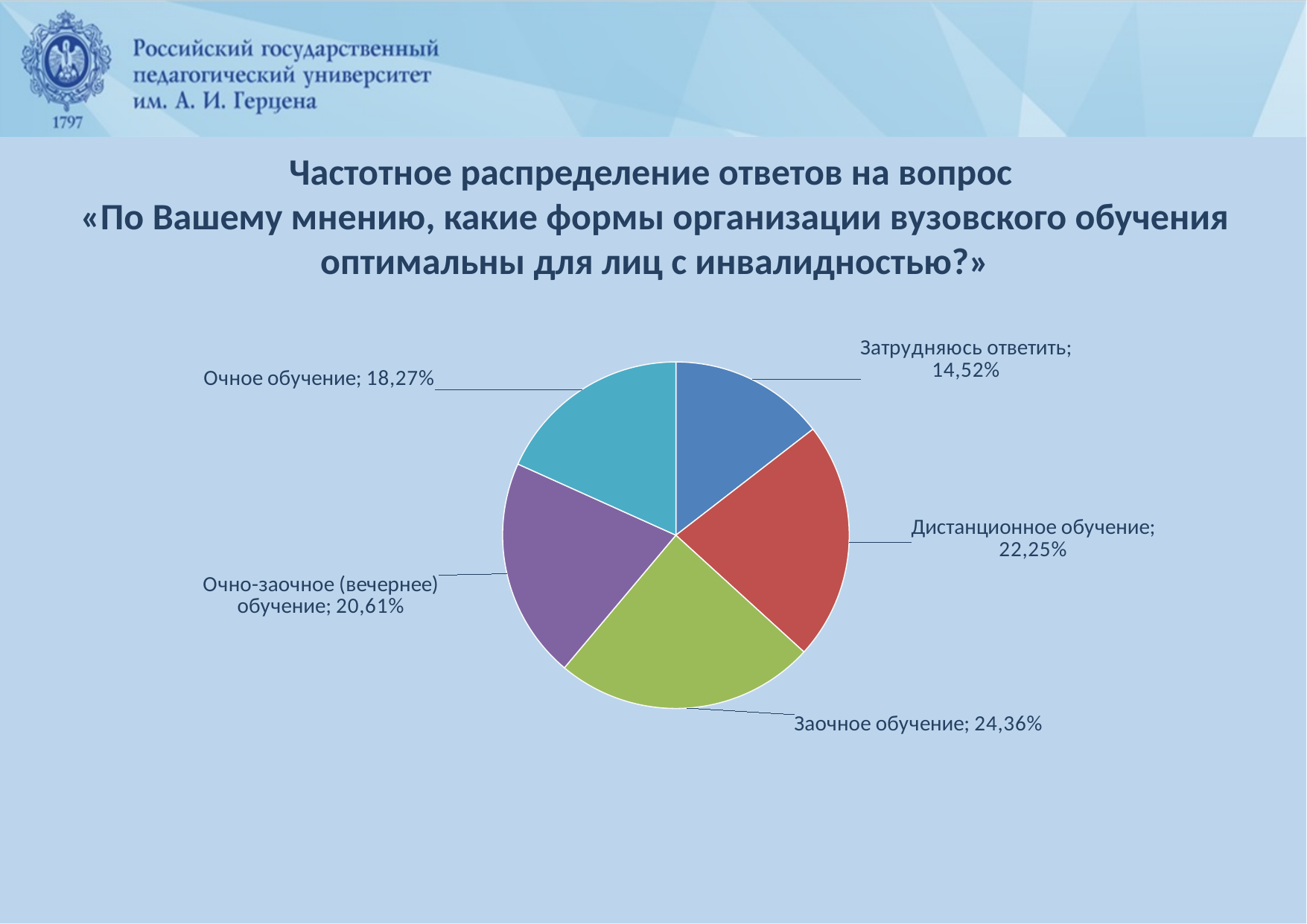
What percentage is shown for "Очное обучение"? 18,27% What is the difference in percentage points between "Заочное обучение" and "Дистанционное обучение"? 2,11 What share of responses does "Дистанционное обучение" have? 22,25% What type of chart is shown on the slide? Pie chart What percentage is shown for "Очно-заочное (вечернее) обучение"? 20,61% Which answer option has the smallest share in the pie chart? Затрудняюсь ответить Which has a larger share: "Очно-заочное (вечернее) обучение" or "Очное обучение"? Очно-заочное (вечернее) обучение What is the difference in percentage points between "Дистанционное обучение" and "Затрудняюсь ответить"? 7,73 How many slices does the pie chart have? 5 What percentage is shown for "Затрудняюсь ответить"? 14,52% What share of responses does "Заочное обучение" have in the pie chart? 24,36% Which answer option has the largest share in the pie chart? Заочное обучение